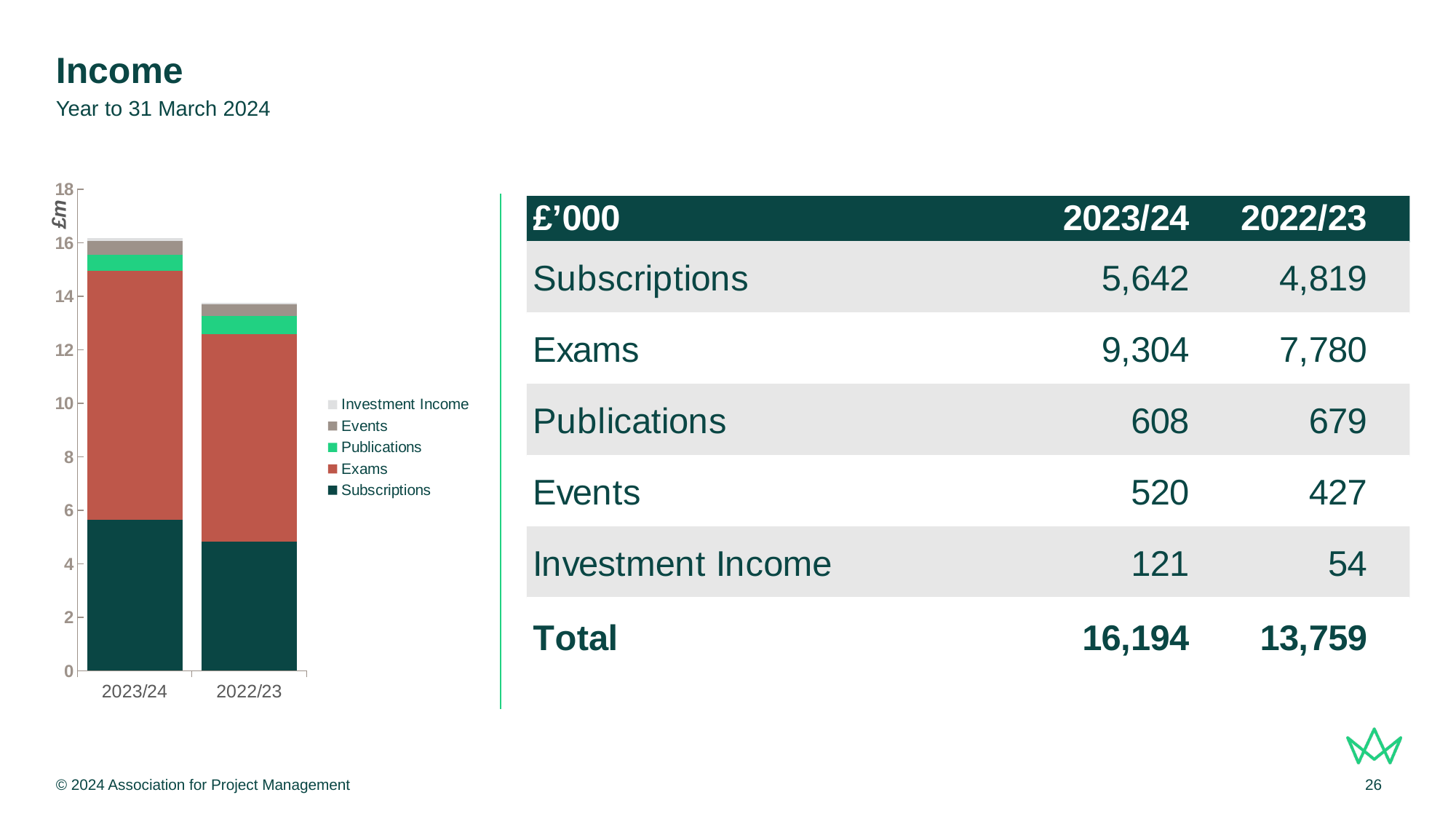
Is the total height of the 2023/24 bar greater or less than 15 on the £m axis? greater Which year has the taller stacked bar, 2023/24 or 2022/23? 2023/24 Which income category forms the smallest segment of the 2022/23 bar? Investment Income Is the total height of the 2022/23 bar greater or less than 14 on the £m axis? less What kind of chart is shown on the slide? Stacked bar chart Which income category forms the largest segment of the 2023/24 bar? Exams How many bars (years) are plotted on the chart? 2 According to the table, what is the Exams income for 2023/24 in £'000? 9,304 Is the Subscriptions segment of the 2023/24 bar greater or less than 6 on the £m axis? less What unit label is shown on the chart's vertical axis? £m How many series does the chart's legend list? 5 According to the table, what is the difference between total income in 2023/24 and 2022/23 in £'000? 2,435